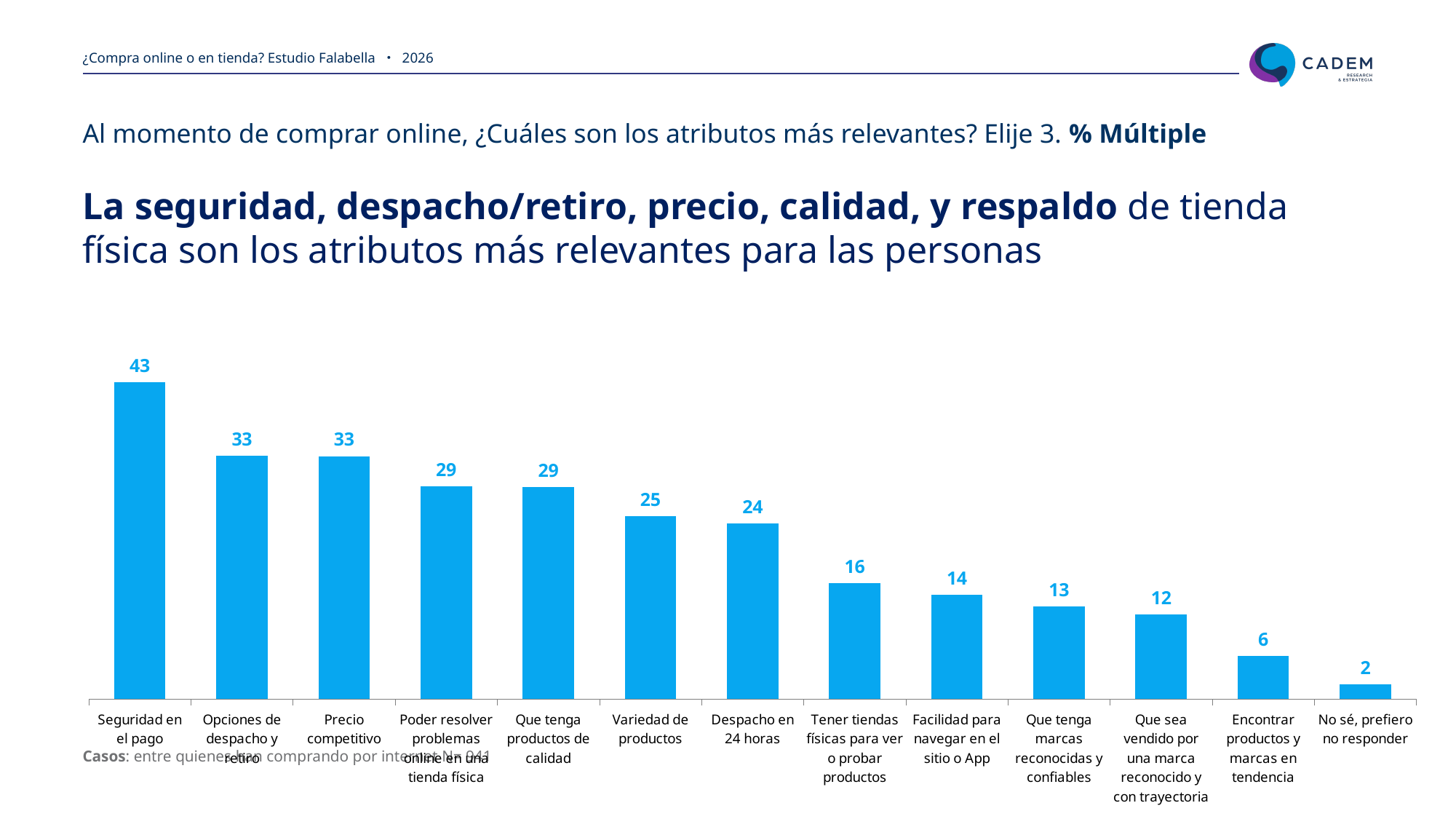
What is the value for "Despacho en 24 horas"? 24 What kind of chart is shown on the slide? Bar chart What is the value for "Seguridad en el pago"? 43 How many categories are shown in the chart? 13 What is the difference between the values for "Variedad de productos" and "Tener tiendas físicas para ver o probar productos"? 9 Which category has the highest value? Seguridad en el pago What colour are the bars in the chart? Blue What is the value for "Que tenga marcas reconocidas y confiables"? 13 Do the values generally rise or fall from left to right along the x axis? Fall What is the difference between the values for "Seguridad en el pago" and "Precio competitivo"? 10 Which is larger, the value for "Facilidad para navegar en el sitio o App" or the value for "Encontrar productos y marcas en tendencia"? Facilidad para navegar en el sitio o App Which category has the lowest value? No sé, prefiero no responder